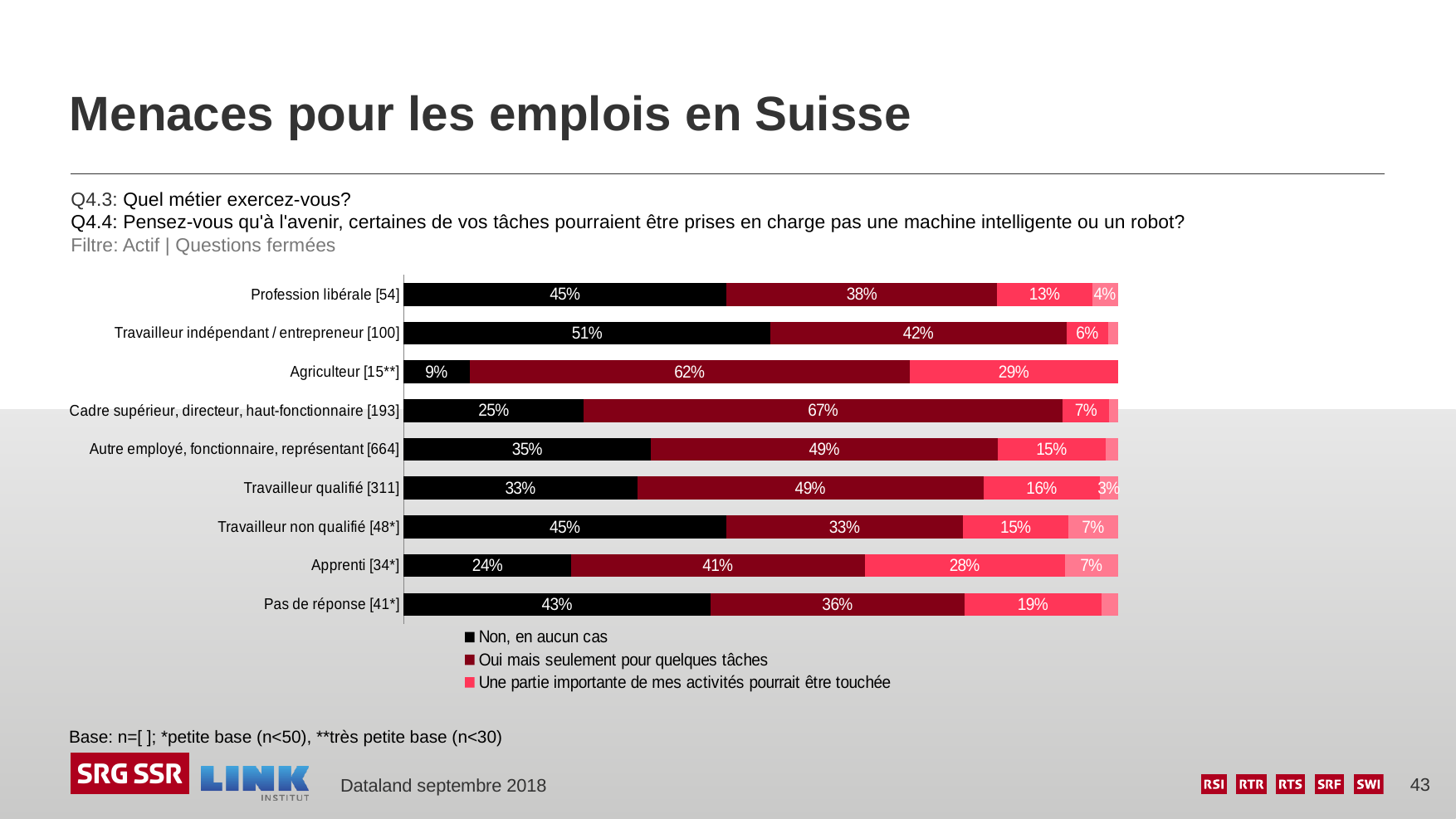
Which category has the highest value for 'Non, en aucun cas'? Travailleur indépendant / entrepreneur Which colour represents 'Non, en aucun cas' in the chart? Black Which category has the highest value for 'Une partie importante de mes activités pourrait être touchée'? Agriculteur For 'Une partie importante de mes activités pourrait être touchée', which is larger: 'Apprenti' or 'Travailleur qualifié'? Apprenti How many occupation categories are shown in the chart? 9 Which category has the lowest value for 'Non, en aucun cas'? Agriculteur What is the value of 'Oui mais seulement pour quelques tâches' for 'Cadre supérieur, directeur, haut-fonctionnaire'? 67% How many series does the legend list? 3 What type of chart is shown on the slide? Stacked horizontal bar chart What percentage of 'Agriculteur' respondents answered 'Non, en aucun cas'? 9% What share of 'Apprenti' respondents said 'Une partie importante de mes activités pourrait être touchée'? 28% What is the difference in percentage points between 'Travailleur indépendant / entrepreneur' and 'Agriculteur' for 'Non, en aucun cas'? 42 percentage points